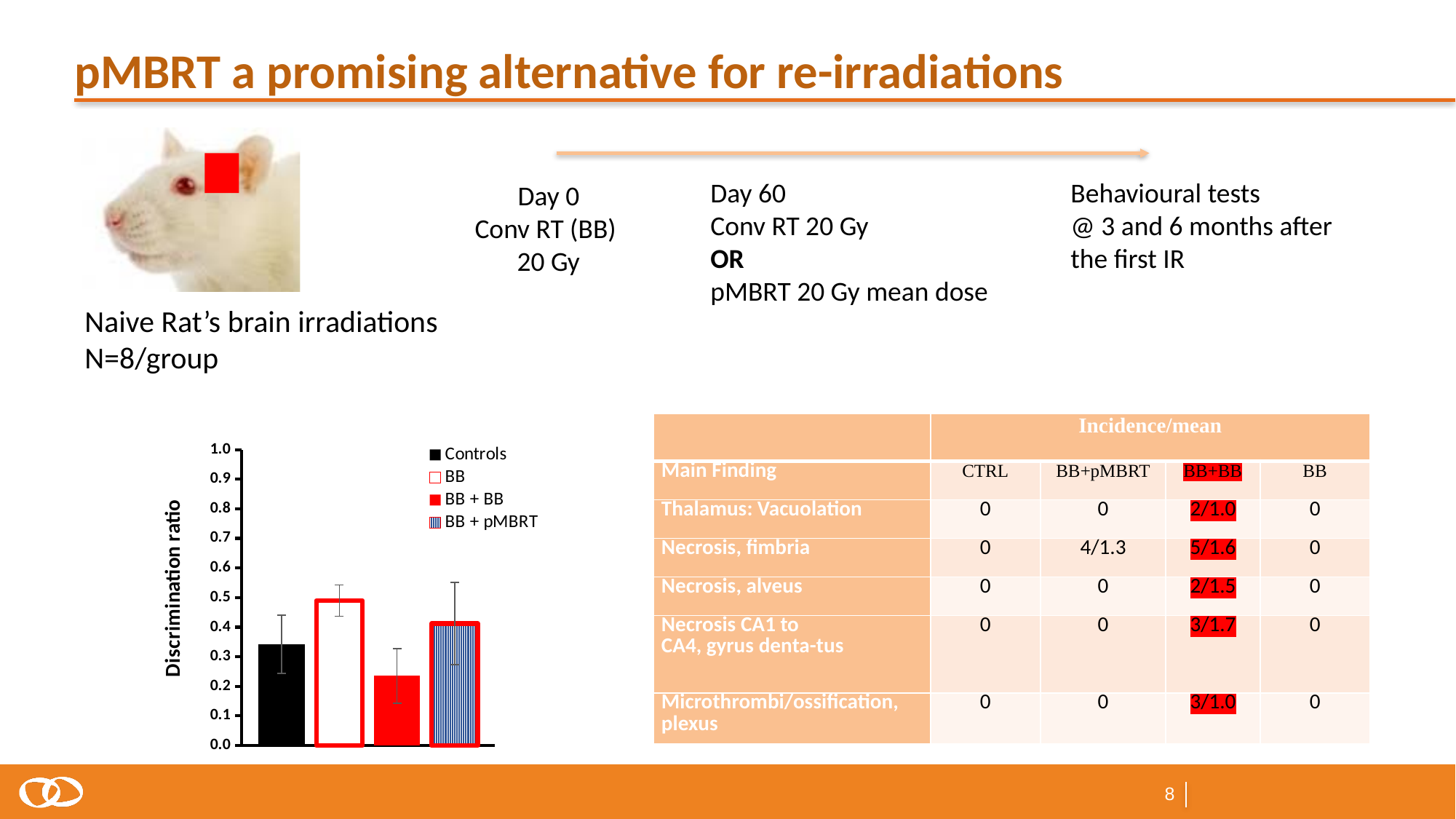
What is the label of the chart's y axis? Discrimination ratio What kind of chart is shown on the slide? bar chart How many bars are plotted in the chart? 4 Which has a higher discrimination ratio, BB or BB + BB? BB Is the discrimination ratio for BB greater or less than 0.4? greater Which group has the lowest discrimination ratio in the chart? BB + BB Is the discrimination ratio for BB + BB greater or less than 0.3? less Which has a higher discrimination ratio, Controls or BB + BB? Controls Is the discrimination ratio for BB + pMBRT greater or less than 0.3? greater Which group has the highest discrimination ratio in the chart? BB How many entries does the chart legend list? 4